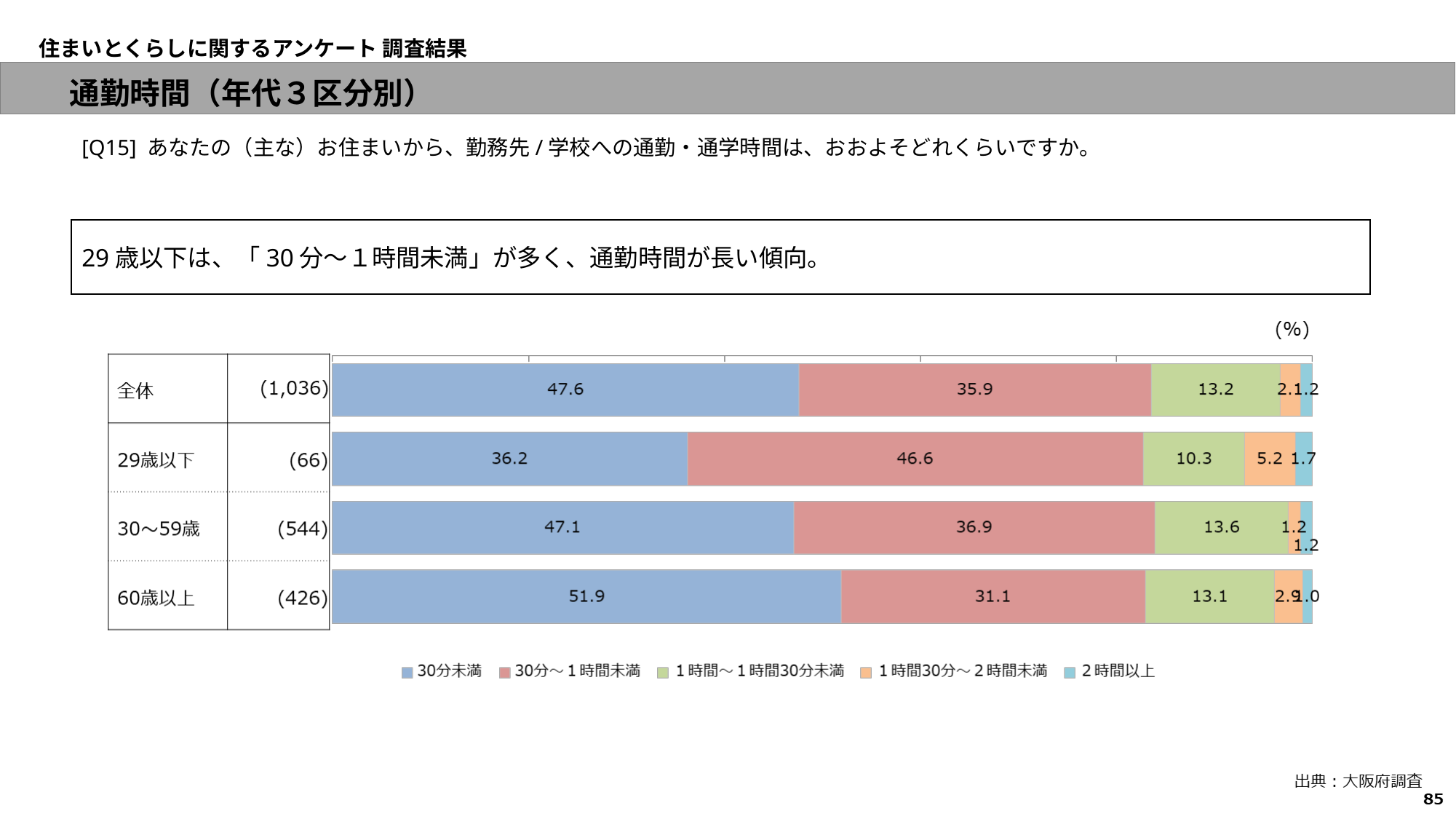
What is the sample size shown for 全体? (1,036) What is the value for 30分未満 in the 60歳以上 bar? 51.9 What kind of chart is shown on the slide? Stacked bar chart Which is larger: the 30分〜1時間未満 value for 29歳以下 or for 60歳以上? 29歳以下 Which category has the lowest value for 30分未満? 29歳以下 How many series does the legend list? 5 Which category has the highest value for 30分未満? 60歳以上 What is the value for 1時間〜1時間30分未満 in the 30〜59歳 bar? 13.6 How many categories (bars) are shown in the chart? 4 What is the difference between the 30分未満 values for 全体 and 29歳以下? 11.4 What is the value for 1時間30分〜2時間未満 in the 29歳以下 bar? 5.2 What is the value for 30分〜1時間未満 in the 29歳以下 bar? 46.6